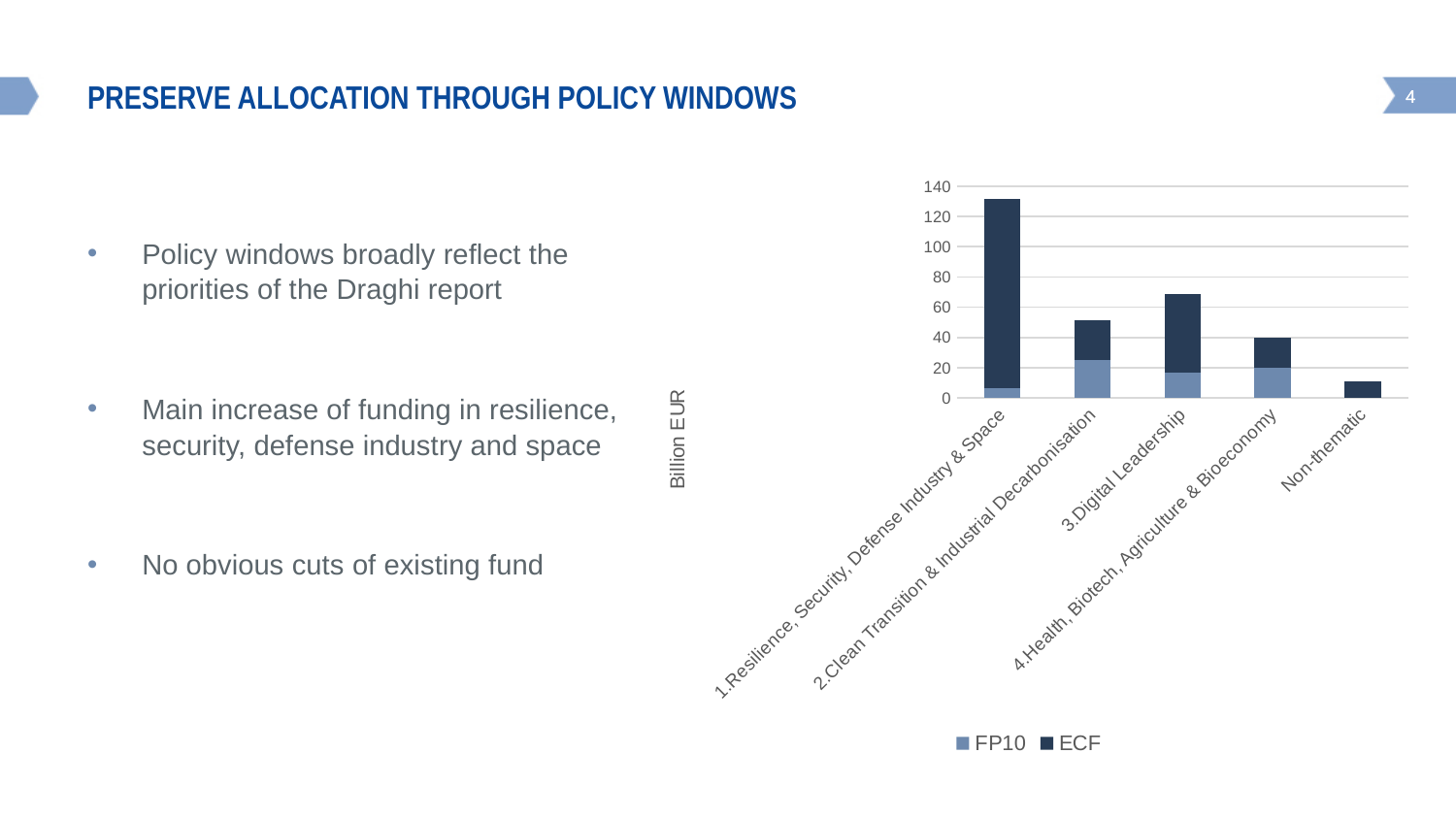
What unit is shown on the vertical axis label of the chart? Billion EUR Which category has the tallest stacked bar in the chart? 1.Resilience, Security, Defense Industry & Space What are the two series names listed in the chart's legend? FP10 and ECF Which has the larger total stacked bar: 3.Digital Leadership or 2.Clean Transition & Industrial Decarbonisation? 3.Digital Leadership How many series does the chart's legend list? 2 Is the total stacked value for 3.Digital Leadership greater or less than 60? greater Which category has the shortest stacked bar in the chart? Non-thematic What kind of chart is shown on the slide? Stacked bar chart Is the total stacked value for 2.Clean Transition & Industrial Decarbonisation greater or less than 60? less Is the total stacked value for 1.Resilience, Security, Defense Industry & Space greater or less than 120? greater How many categories are shown on the x axis of the chart? 5